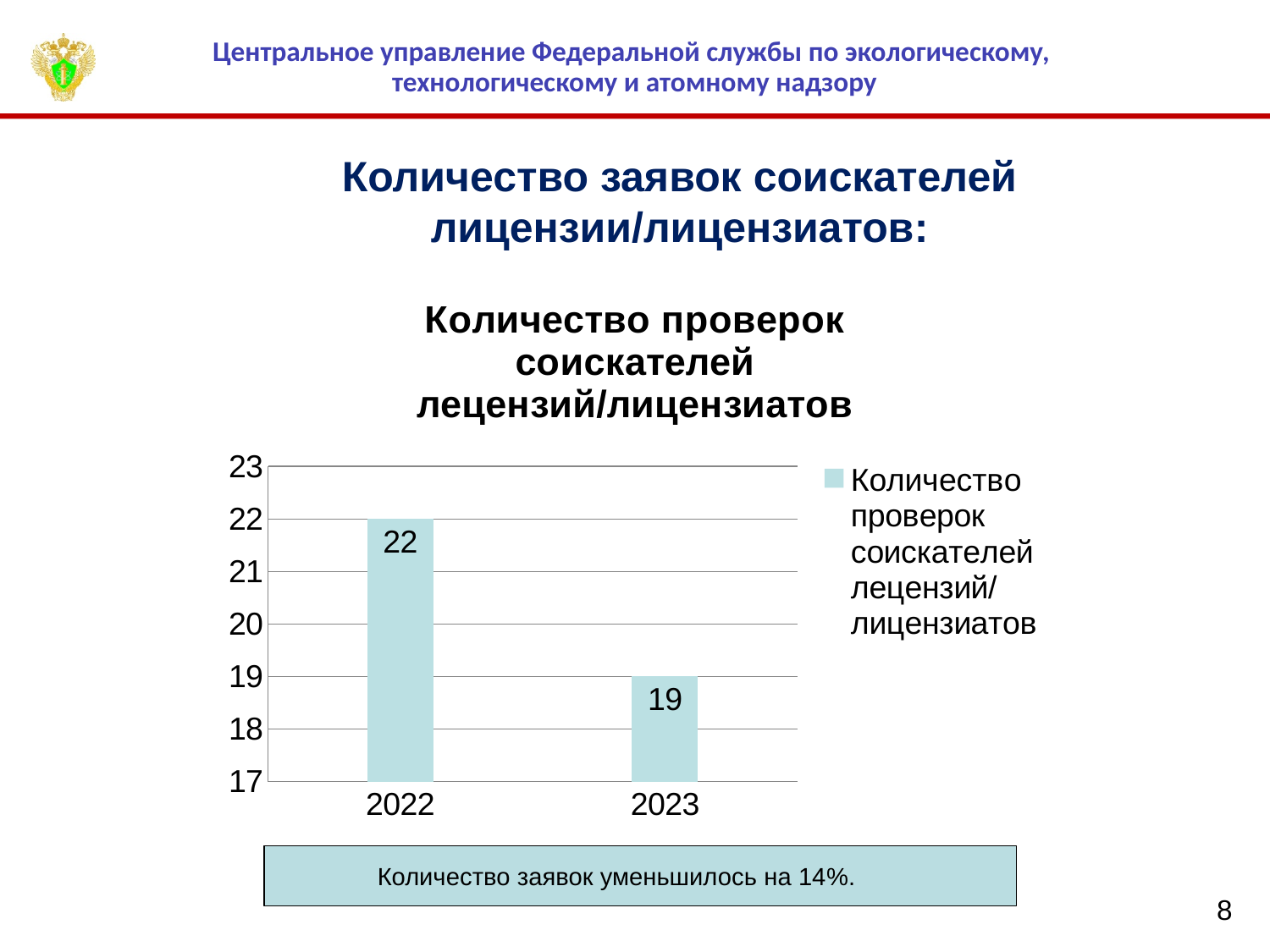
What is the value for 2023? 19 What is the value for 2022? 22 Which year has the lowest value? 2023 What kind of chart is shown? bar chart What is the difference between the values for 2022 and 2023? 3 Do the values rise or fall from 2022 to 2023? fall Which year has the highest value? 2022 How many series does the legend list? 1 Is the value for 2023 greater or less than 20? less Is the value for 2022 greater or less than 21? greater Which is larger, the value for 2022 or the value for 2023? 2022 How many years are shown on the x axis? 2